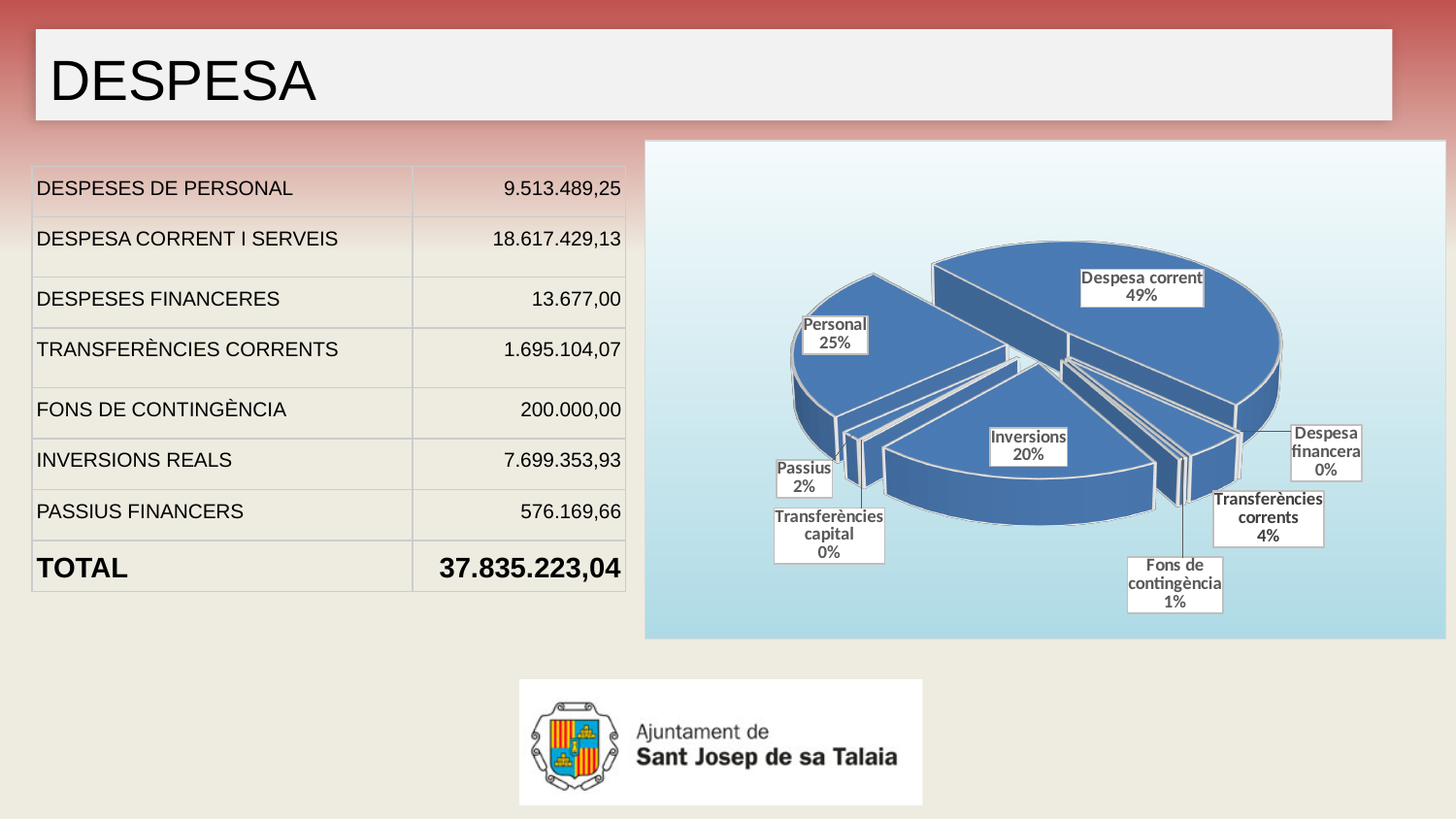
What percentage is shown for Passius in the pie chart? 2% What percentage is shown for Transferències corrents in the pie chart? 4% Which is larger in the pie chart, Personal or Inversions? Personal What is the title of the slide containing the pie chart? DESPESA Which slice of the pie chart is the largest? Despesa corrent What percentage is shown for Personal in the pie chart? 25% What kind of chart is shown on the slide? pie chart What percentage is shown for Inversions in the pie chart? 20% What share of the pie does Despesa corrent represent? 49% What percentage is shown for Fons de contingència in the pie chart? 1% What is the difference in percentage points between Despesa corrent and Personal? 24 How many slices are labelled in the pie chart? 8